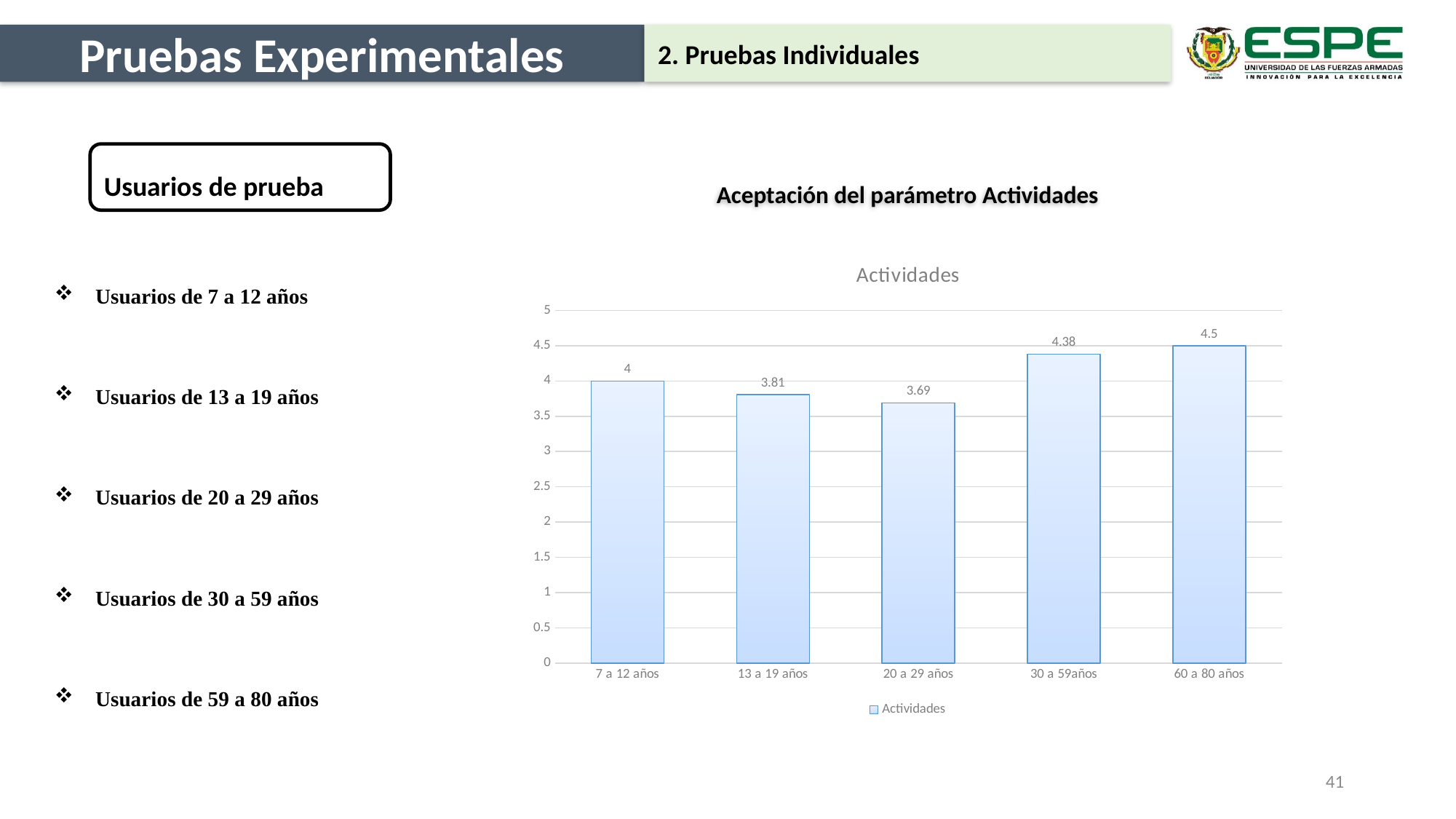
What is the value for "30 a 59años" in the Actividades chart? 4.38 What series name does the legend of the Actividades chart list? Actividades What kind of chart is the Actividades chart? bar chart Which age group has the highest value in the Actividades chart? 60 a 80 años How many age groups are shown in the Actividades chart? 5 Which is larger in the Actividades chart: the value for "13 a 19 años" or "30 a 59años"? 30 a 59años What is the value for "20 a 29 años" in the Actividades chart? 3.69 Which age group has the lowest value in the Actividades chart? 20 a 29 años What is the value for "13 a 19 años" in the Actividades chart? 3.81 Is the value for "20 a 29 años" in the Actividades chart greater or less than 4? less What is the difference between the values for "60 a 80 años" and "20 a 29 años" in the Actividades chart? 0.81 What is the value for "7 a 12 años" in the Actividades chart? 4